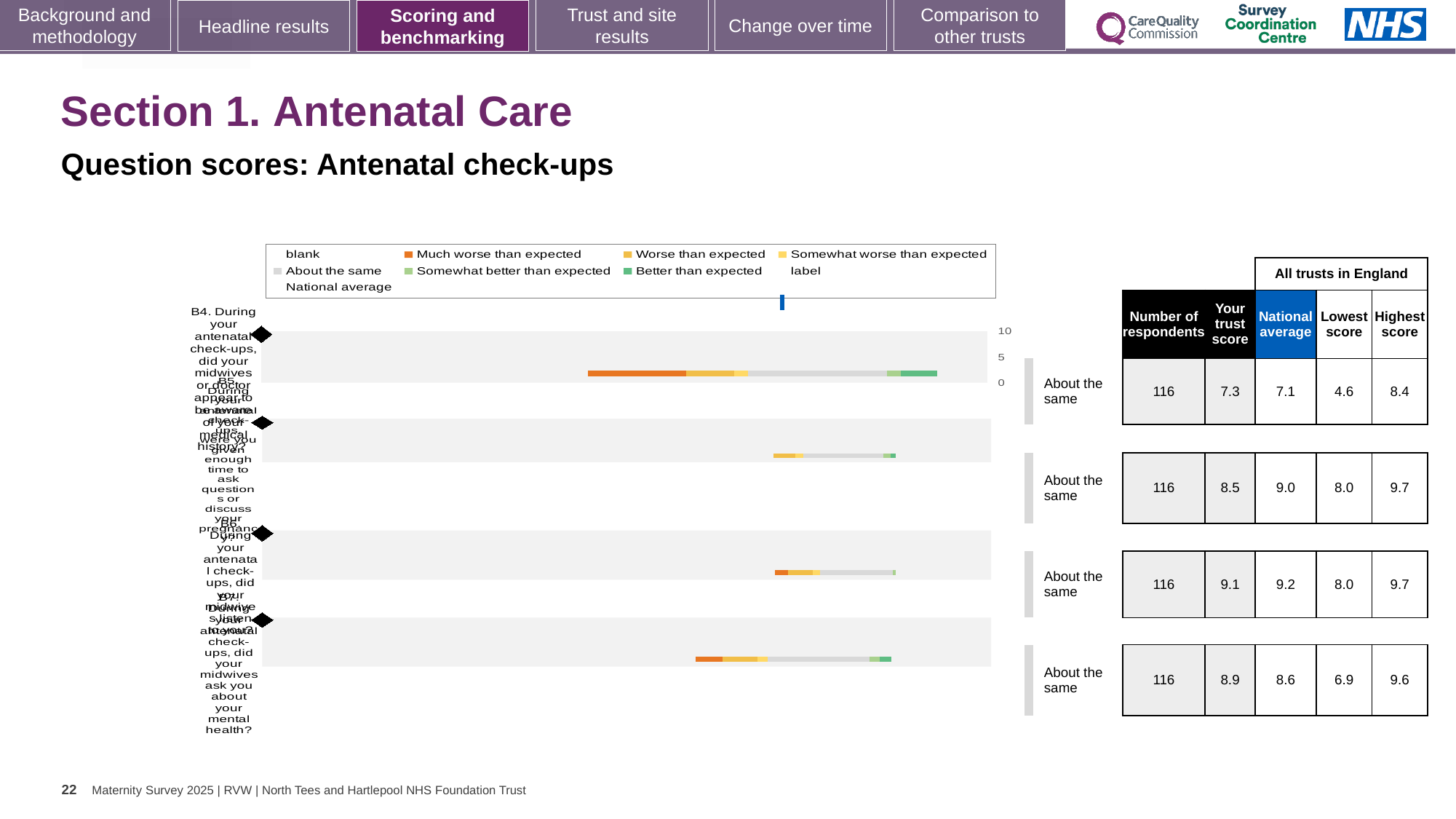
What benchmark category is shown for every question row in the chart? About the same For the second question row (B5), which is larger: the trust score or the national average? National average (9.0) What is the number of respondents for the third question row (B6)? 116 What is the lowest score among all trusts in England for the first question row (B4)? 4.6 What is the difference between the trust score and the national average for the first question row (B4)? 0.2 What is the highest score among all trusts in England for the fourth question row (B7)? 9.6 What is the national average for the second question row (B5)? 9.0 Which question row has the highest 'Your trust score'? B6 (third row), 9.1 What is the 'Your trust score' for the first question row (B4)? 7.3 What kind of chart is shown on the slide? bar chart How many question rows (bars) are plotted in the chart? 4 Which question row has the lowest 'Your trust score'? B4 (first row), 7.3